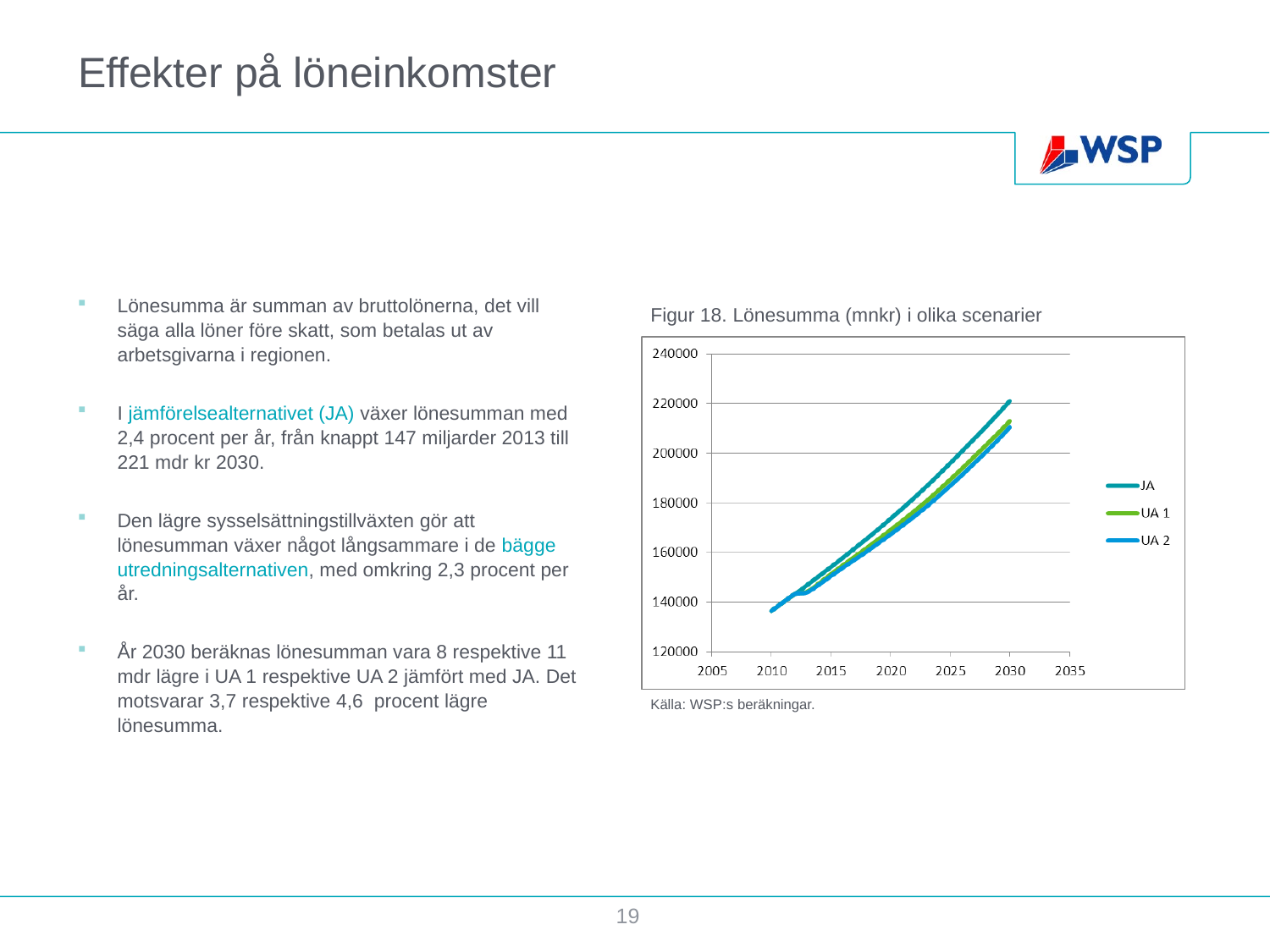
How many series does the legend of the chart list? 3 Is the value for JA in 2030 greater or less than 200000? greater Which series has the highest value in 2030? JA Do the values in the chart rise or fall from 2010 to 2030? Rise What kind of chart is shown in Figur 18? Line chart Which series are listed in the chart's legend? JA, UA 1, UA 2 What is the title of the chart? Figur 18. Lönesumma (mnkr) i olika scenarier Is the value for UA 2 in 2030 greater or less than 220000? less Is the value for UA 1 in 2020 greater or less than 180000? less In 2030, which is larger: the value for JA or the value for UA 2? JA What is the highest value shown on the chart's vertical axis? 240000